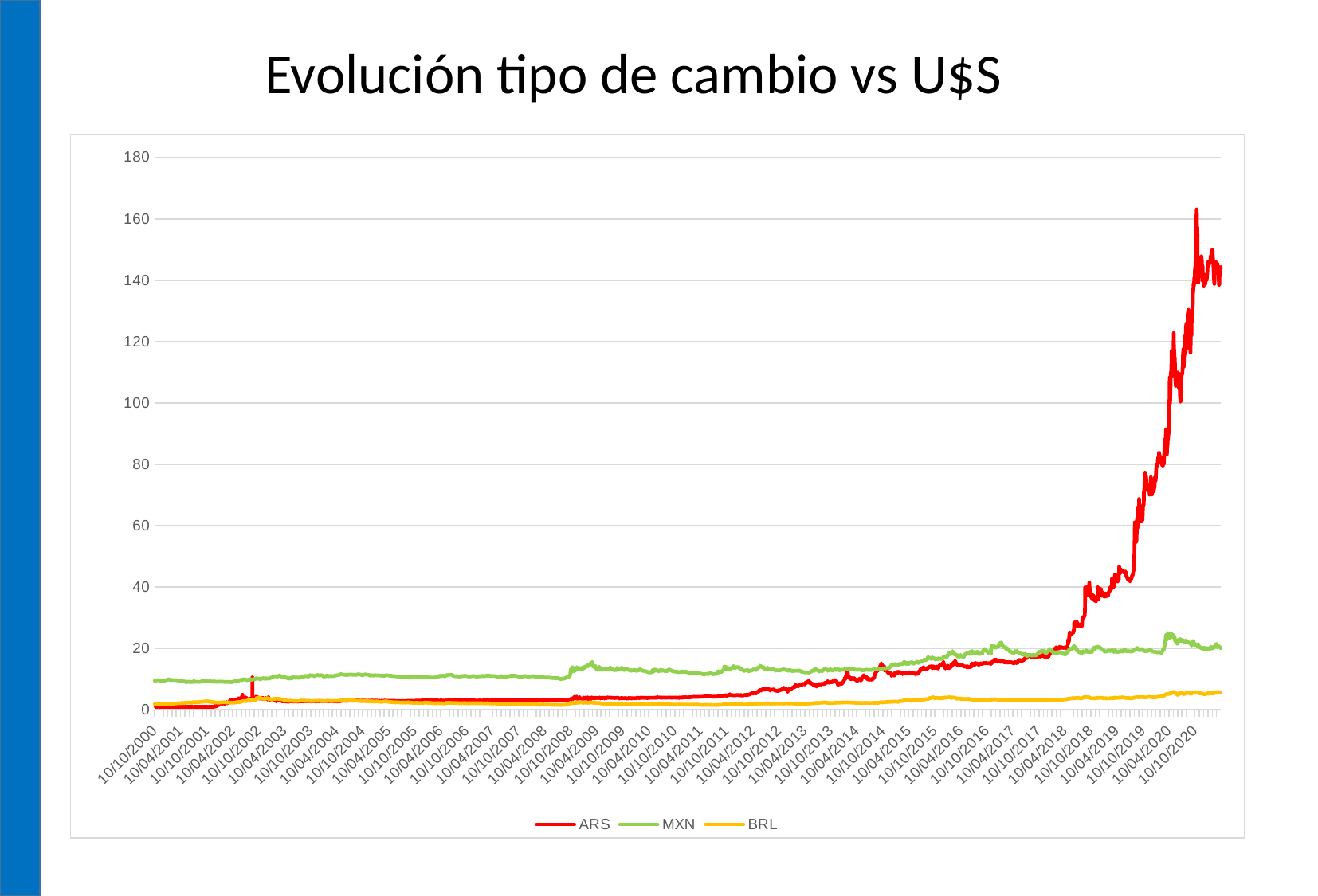
Which series has the highest value at the right end of the chart (around 10/10/2020)? ARS Around 10/10/2020, which is larger, the value for ARS or the value for MXN? ARS Does the ARS series rise or fall overall from 10/10/2000 to 10/10/2020? rise What is the title of the chart? Evolución tipo de cambio vs U$S What kind of chart is shown on the slide? line chart At the right end of the chart, is the value for ARS greater or less than 120? greater Does the BRL series ever exceed 20 on the chart? No How many series does the legend list? 3 What is the highest value shown on the vertical axis? 180 At the right end of the chart, is the value for MXN greater or less than 40? less Which series has the lowest value at the right end of the chart (around 10/10/2020)? BRL Which series is drawn in red? ARS